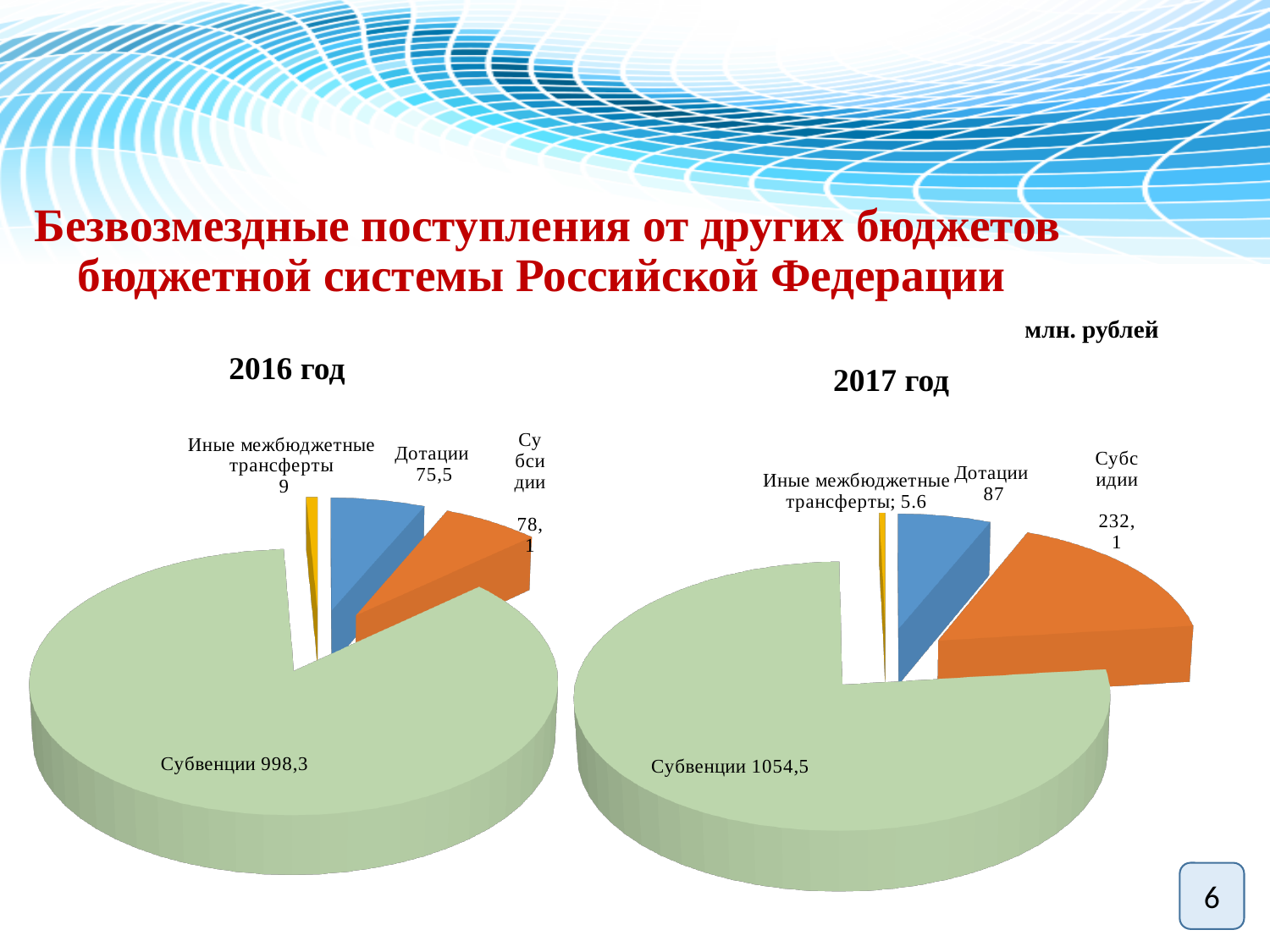
In the 2016 год chart, what is the value for Дотации? 75,5 In the 2016 год chart, which category has the smallest slice? Иные межбюджетные трансферты In the 2016 год chart, which is larger, Дотации or Субсидии? Субсидии What kind of chart is the 2016 год chart? Pie chart In the 2017 год chart, which category has the largest slice? Субвенции What unit is stated for the values on the slide? млн. рублей In the 2017 год chart, what is the difference between Субсидии and Дотации? 145,1 How many slices does the 2017 год chart have? 4 In the 2017 год chart, what is the value for Субсидии? 232,1 In the 2016 год chart, what is the value for Субвенции? 998,3 In the 2017 год chart, what is the value for Иные межбюджетные трансферты? 5.6 What is the difference between the Субвенции value in the 2017 год chart and the Субвенции value in the 2016 год chart? 56,2